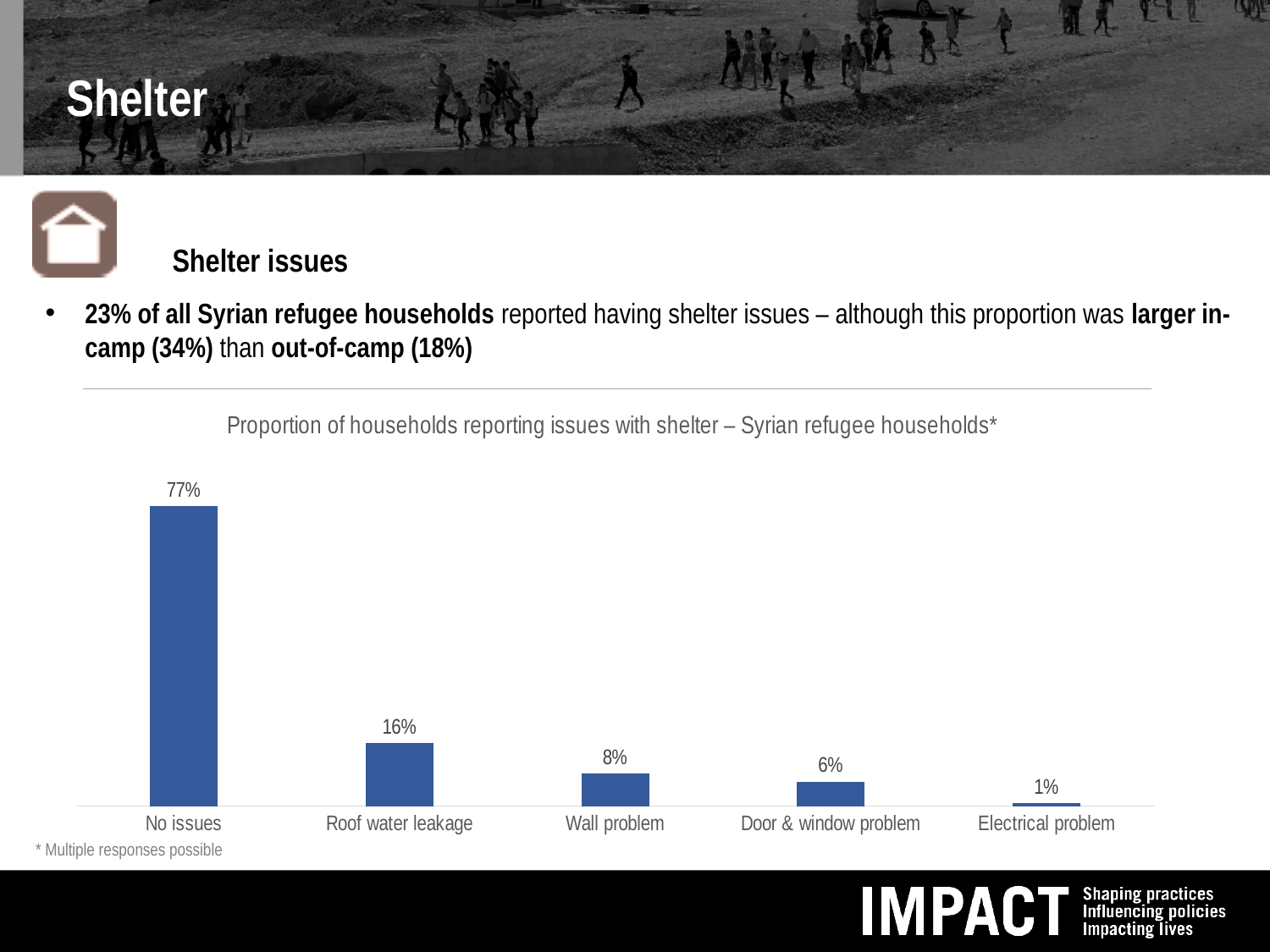
What proportion of households reported a door & window problem? 6% What is the difference between the proportion reporting roof water leakage and the proportion reporting a wall problem? 8% What is the title of the chart? Proportion of households reporting issues with shelter – Syrian refugee households* Which category has the highest value in the chart? No issues Which is larger: the value for Wall problem or the value for Door & window problem? Wall problem What kind of chart is shown on the slide? Bar chart Which category has the lowest value in the chart? Electrical problem What proportion of households reported an electrical problem? 1% How many categories are shown in the chart? 5 What proportion of households reported roof water leakage? 16% What proportion of households reported a wall problem? 8% What proportion of households reported no issues with shelter? 77%